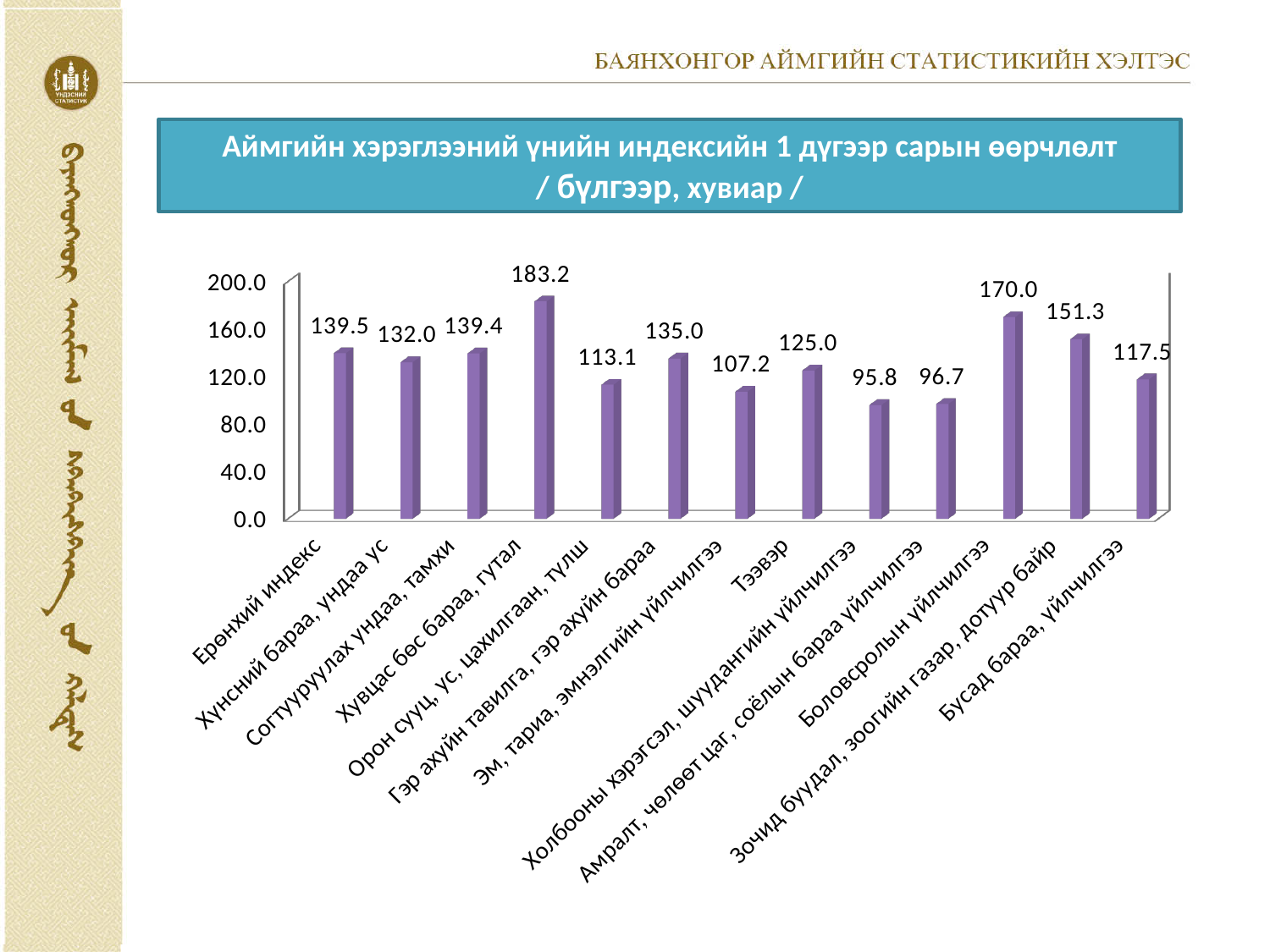
Which category has the lowest value? Холбооны хэрэгсэл, шуудангийн үйлчилгээ Is the value for Орон сууц, ус, цахилгаан, түлш greater or less than 120.0? less What is the difference between the values for Боловсролын үйлчилгээ and Зочид буудал, зоогийн газар, дотуур байр? 18.7 What is the value for Ерөнхий индекс? 139.5 How many categories are shown on the chart? 13 What is the title of the chart on the slide? Аймгийн хэрэглээний үнийн индексийн 1 дүгээр сарын өөрчлөлт / бүлгээр, хувиар / Which category has the highest value? Хувцас бөс бараа, гутал Which is larger, the value for Хүнсний бараа, ундаа ус or the value for Гэр ахуйн тавилга, гэр ахуйн бараа? Гэр ахуйн тавилга, гэр ахуйн бараа What is the value for Хувцас бөс бараа, гутал? 183.2 What is the value for Боловсролын үйлчилгээ? 170.0 What is the value for Тээвэр? 125.0 What kind of chart is shown on the slide? bar chart